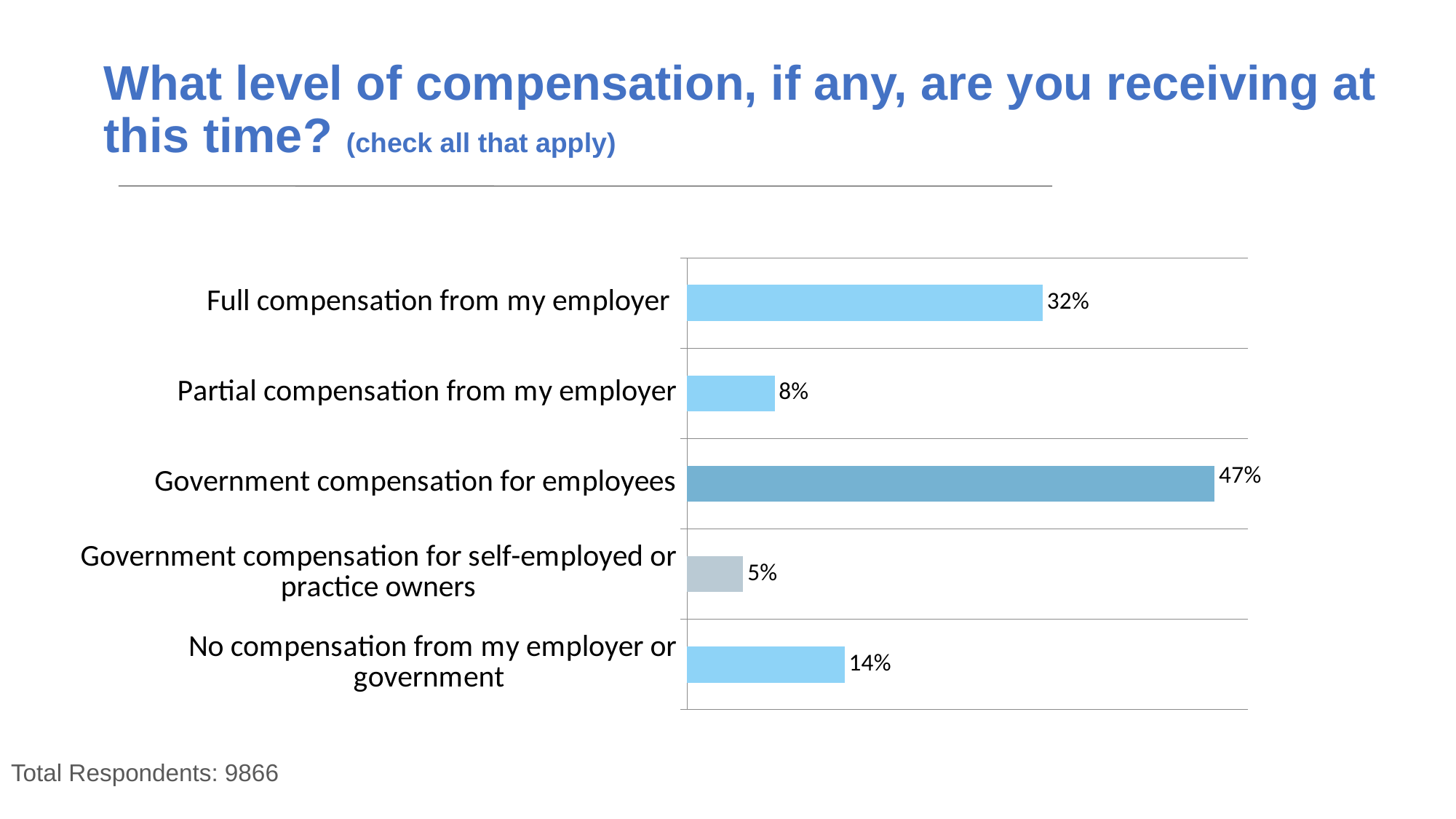
What is the value for 'Government compensation for employees'? 47% Which is larger: 'Full compensation from my employer' or 'No compensation from my employer or government'? Full compensation from my employer What percentage of respondents reported no compensation from their employer or government? 14% What type of chart is shown on the slide? Bar chart Which category has the highest value? Government compensation for employees Which category has the lowest value? Government compensation for self-employed or practice owners What is the total number of respondents stated on the slide? 9866 What is the value for 'Partial compensation from my employer'? 8% What percentage of respondents reported receiving full compensation from their employer? 32% How many categories are shown in the chart? 5 What is the difference between 'No compensation from my employer or government' and 'Partial compensation from my employer'? 6% What is the difference between 'Government compensation for employees' and 'Full compensation from my employer'? 15%